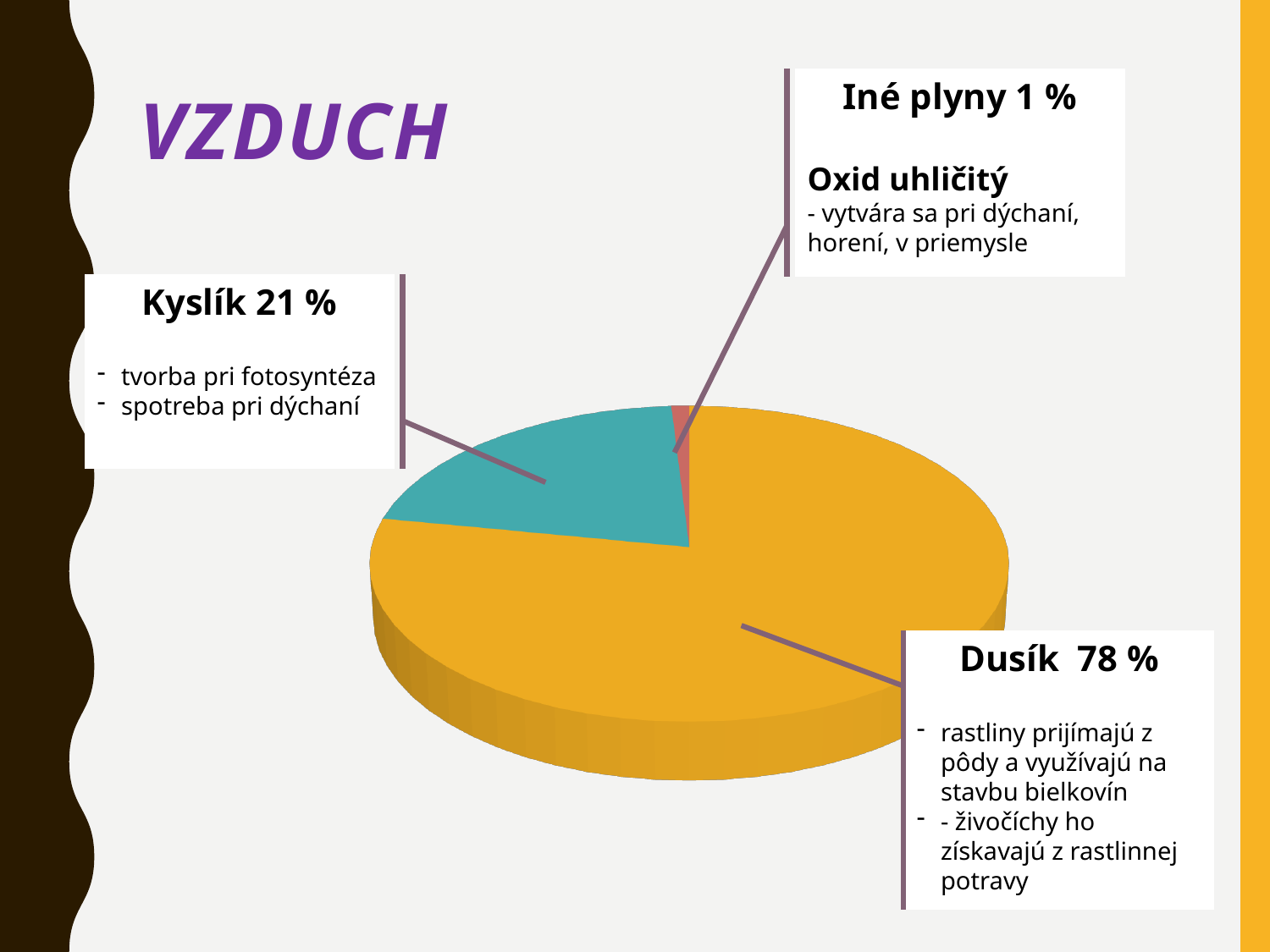
How many slices does the pie chart have? 3 Which slice of the pie chart is the largest? Dusík What is the title of the slide containing the pie chart? VZDUCH What share of the pie does Dusík represent? 78 % What is the difference in percentage points between Kyslík and Iné plyny? 20 What colour is the Dusík slice of the pie chart? yellow/orange Which slice of the pie chart is the smallest? Iné plyny What kind of chart is shown on the slide? pie chart What share of the pie does Kyslík represent? 21 % What share of the pie does Iné plyny represent? 1 % What is the difference in percentage points between Dusík and Kyslík? 57 Which is larger, the share for Kyslík or the share for Iné plyny? Kyslík